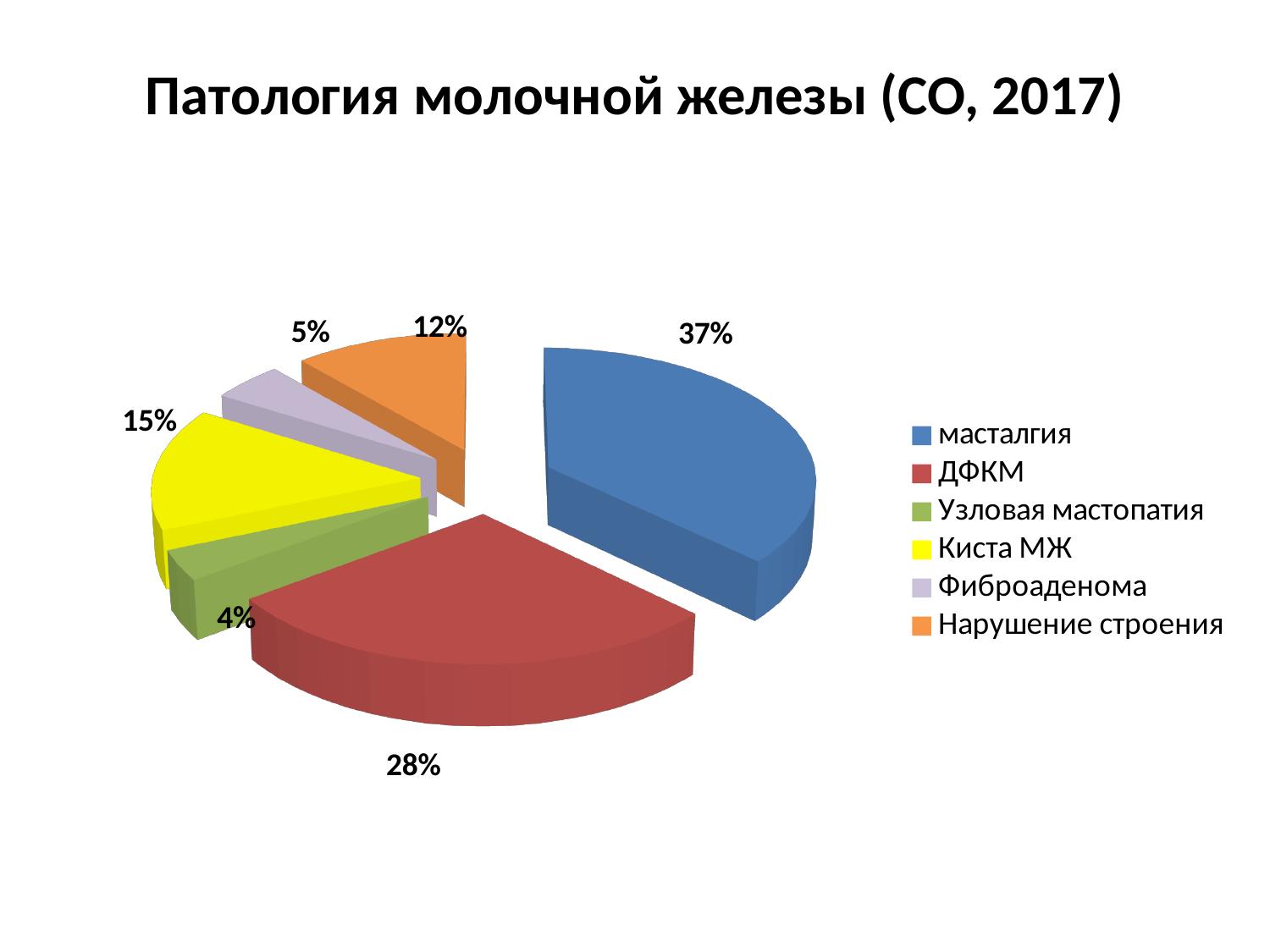
What is the value shown for Нарушение строения? 12% What is the value shown for Киста МЖ? 15% What is the title of the chart? Патология молочной железы (СО, 2017) What share of the pie does масталгия account for? 37% What kind of chart is shown on the slide? pie chart Which category has the largest slice of the pie? масталгия Which is larger, Киста МЖ or Нарушение строения? Киста МЖ What is the value shown for ДФКМ? 28% What is the value shown for Фиброаденома? 5% Which category has the smallest slice of the pie? Узловая мастопатия How many categories does the pie chart show? 6 What is the difference in percentage points between масталгия and ДФКМ? 9